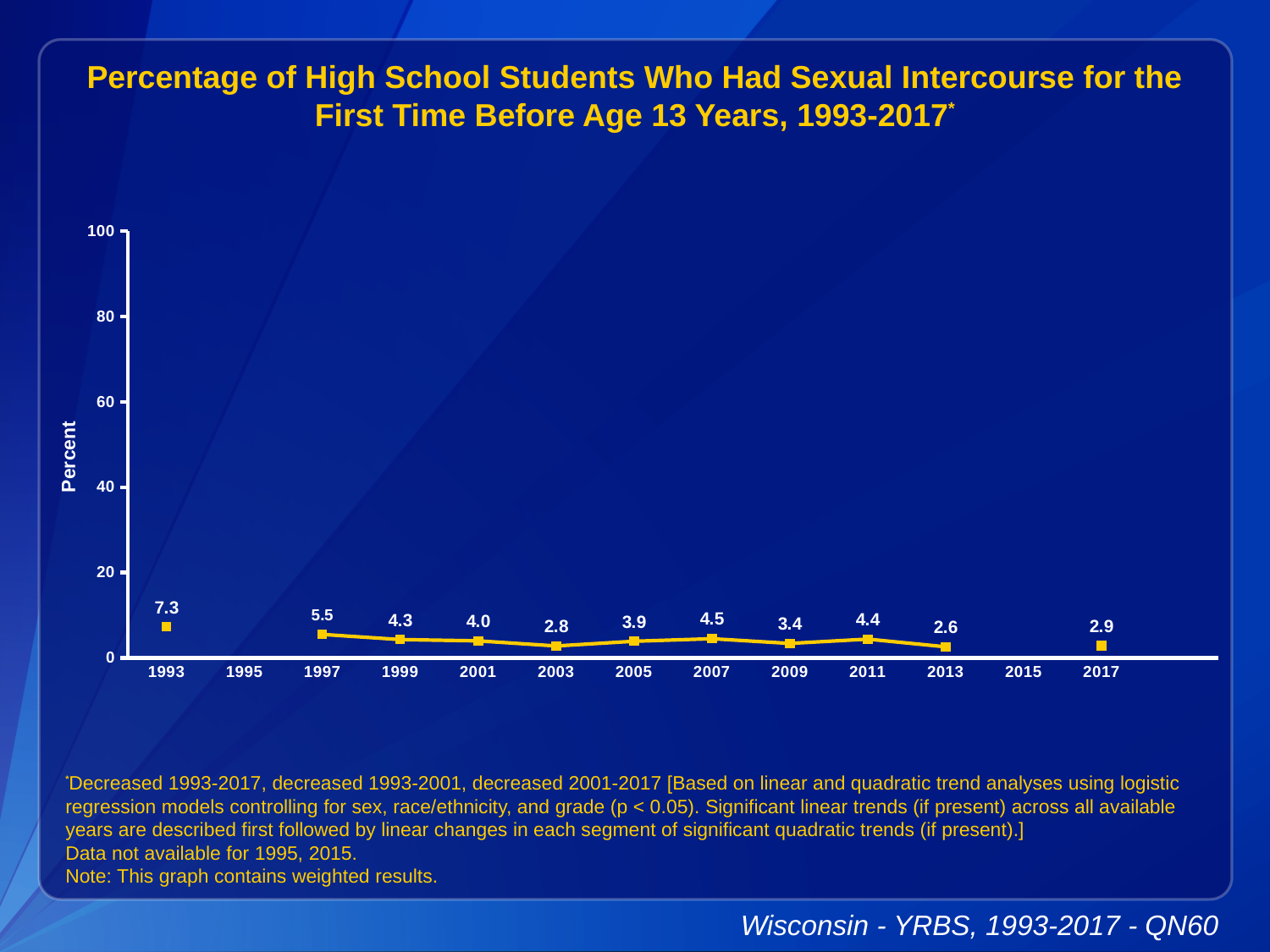
How many years have a plotted data point? 11 What is the value for 1993? 7.3 Do the values generally rise or fall from 1993 to 2017? fall What is the value for 2017? 2.9 Is the value for 1993 greater or less than 20? less What kind of chart is this? line chart What is the difference between the values for 1993 and 2017? 4.4 Which year has the lowest value? 2013 Which year has the highest value? 1993 What is the label on the y axis? Percent Which is larger, the value for 2007 or the value for 2009? 2007 What is the value for 2003? 2.8